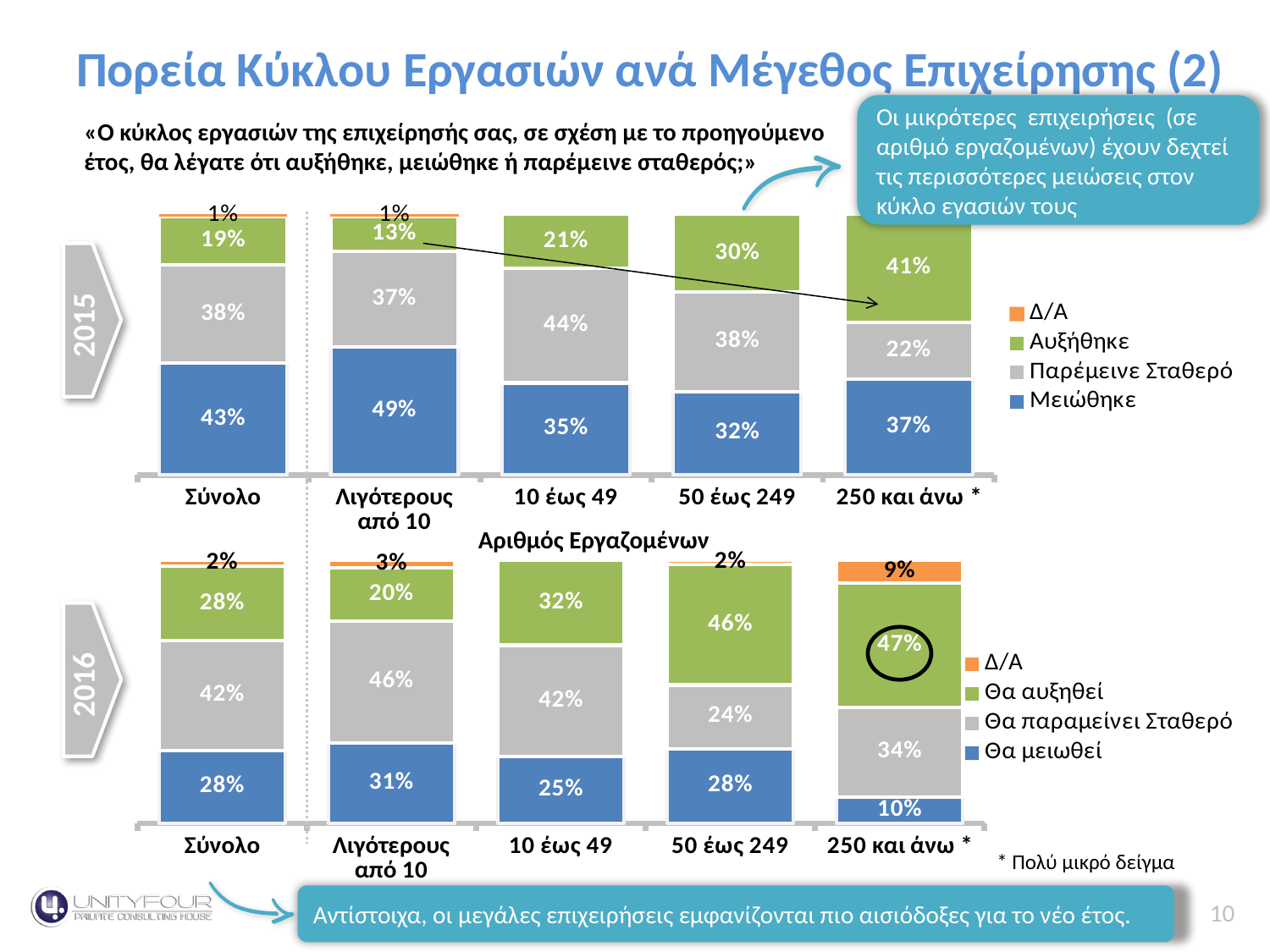
In the 2015 chart (top), what percentage of businesses with 'Λιγότερους από 10' employees answered 'Μειώθηκε'? 49% In the 2016 chart (bottom), which is larger: the 'Θα αυξηθεί' value for '10 έως 49' or for '50 έως 249'? 50 έως 249 In the 2015 chart (top), what is the difference between the 'Αυξήθηκε' values for '250 και άνω' and 'Λιγότερους από 10'? 28% How many categories are shown along the x axis of the 2016 chart (bottom)? 5 In the 2015 chart (top), which category has the highest 'Μειώθηκε' value? Λιγότερους από 10 In the 2015 chart (top), what is the 'Αυξήθηκε' value for the '250 και άνω' category? 41% What type of chart is the 2015 chart (top)? Stacked bar chart In the 2016 chart (bottom), what is the 'Δ/Α' value for the '250 και άνω' category? 9% In the 2016 chart (bottom), what is the total of the 'Θα αυξηθεί', 'Θα παραμείνει Σταθερό' and 'Θα μειωθεί' segments for the 'Σύνολο' bar? 98% In the 2016 chart (bottom), which category has the lowest 'Θα μειωθεί' value? 250 και άνω In the 2016 chart (bottom), what is the 'Θα μειωθεί' value for the '250 και άνω' category? 10% How many series does the legend of the 2015 chart (top) list? 4